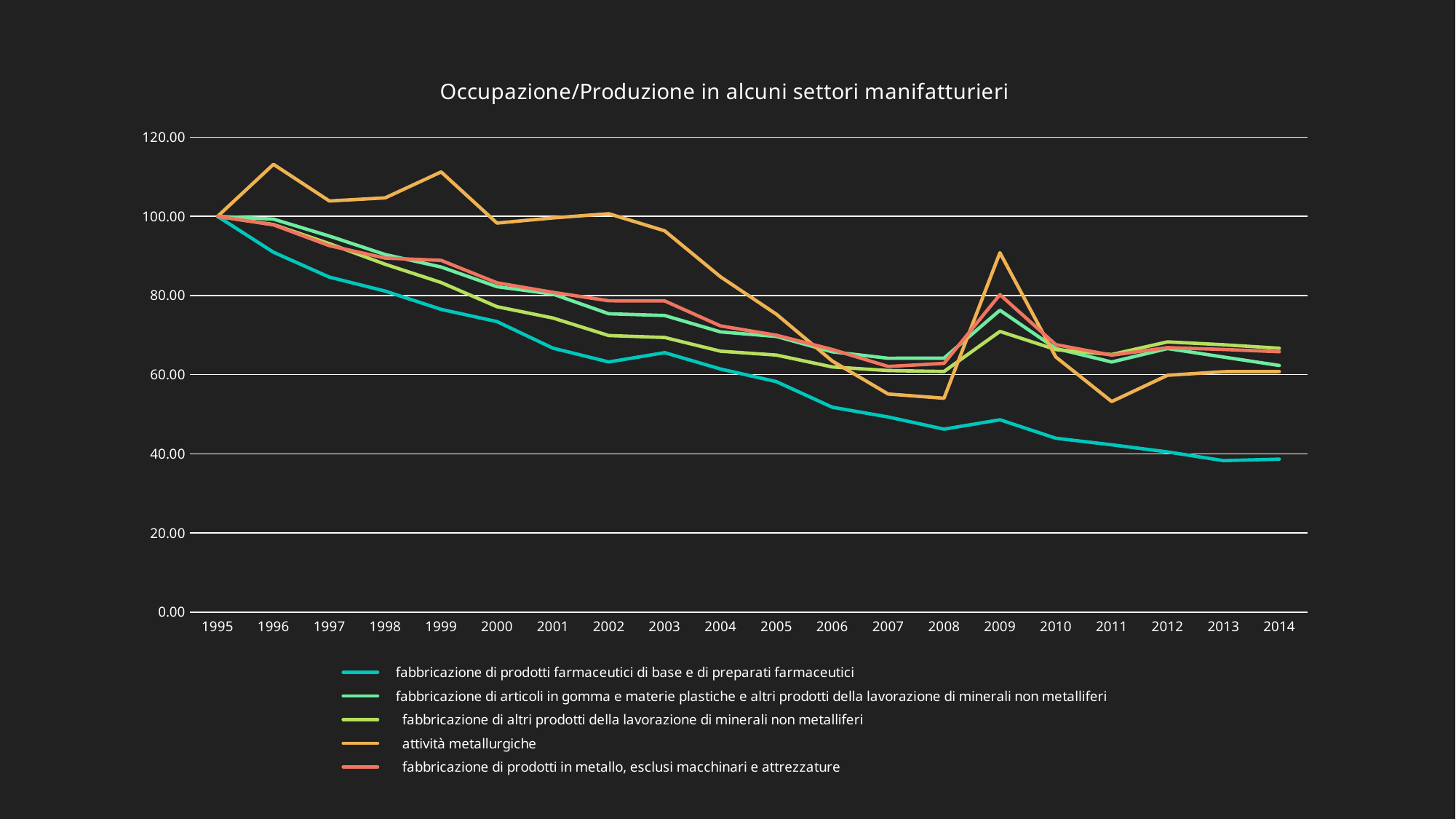
Which series has the lowest value in 2014? fabbricazione di prodotti farmaceutici di base e di preparati farmaceutici How many years are shown along the x axis? 20 In 2009, which is larger: the value for attività metallurgiche or the value for fabbricazione di prodotti farmaceutici di base e di preparati farmaceutici? attività metallurgiche Which series has the highest value in 2009? attività metallurgiche What is the value for attività metallurgiche in 1995? 100.00 How many series does the legend list? 5 What is the title of the chart? Occupazione/Produzione in alcuni settori manifatturieri Is the value for attività metallurgiche in 1996 greater or less than 100? greater What kind of chart is shown on the slide? line chart Does the line for fabbricazione di prodotti farmaceutici di base e di preparati farmaceutici rise or fall from 1995 to 2014? fall Is the value for attività metallurgiche in 2011 greater or less than 60? less Is the value for fabbricazione di prodotti farmaceutici di base e di preparati farmaceutici in 2006 greater or less than 60? less